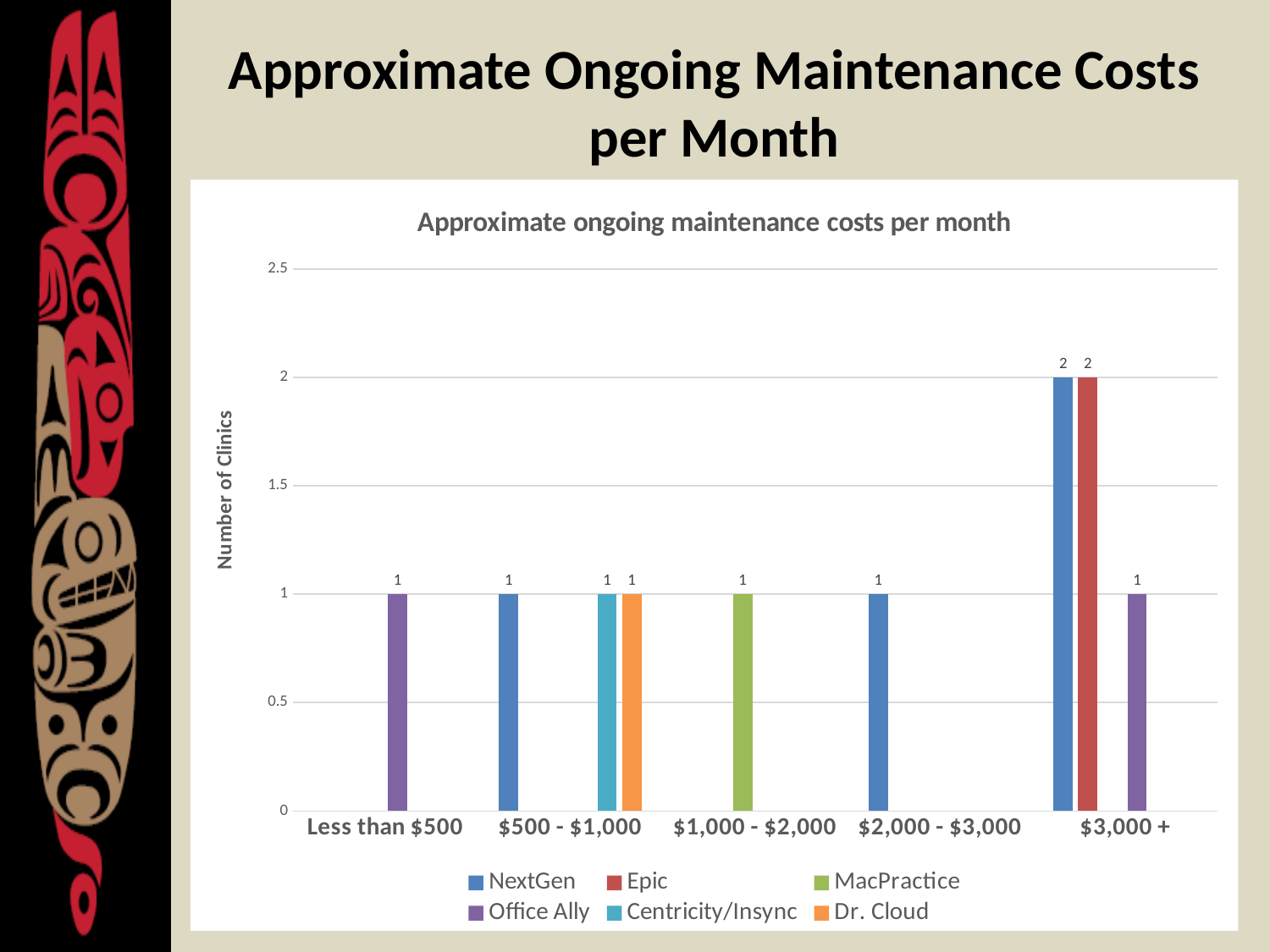
How many series does the legend list? 6 How many cost categories are shown on the x axis? 5 What is the difference between the Epic value and the Office Ally value in the $3,000 + category? 1 What is the label of the y axis? Number of Clinics What is the number of clinics for Office Ally in the Less than $500 category? 1 What is the number of clinics for Dr. Cloud in the $500 - $1,000 category? 1 Which series is shown in orange in the legend? Dr. Cloud What is the number of clinics for MacPractice in the $1,000 - $2,000 category? 1 What is the number of clinics for NextGen in the $3,000 + category? 2 What is the number of clinics for Epic in the $3,000 + category? 2 What type of chart is shown on the slide? Bar chart Which is larger: NextGen in the $3,000 + category or NextGen in the $2,000 - $3,000 category? NextGen in the $3,000 + category